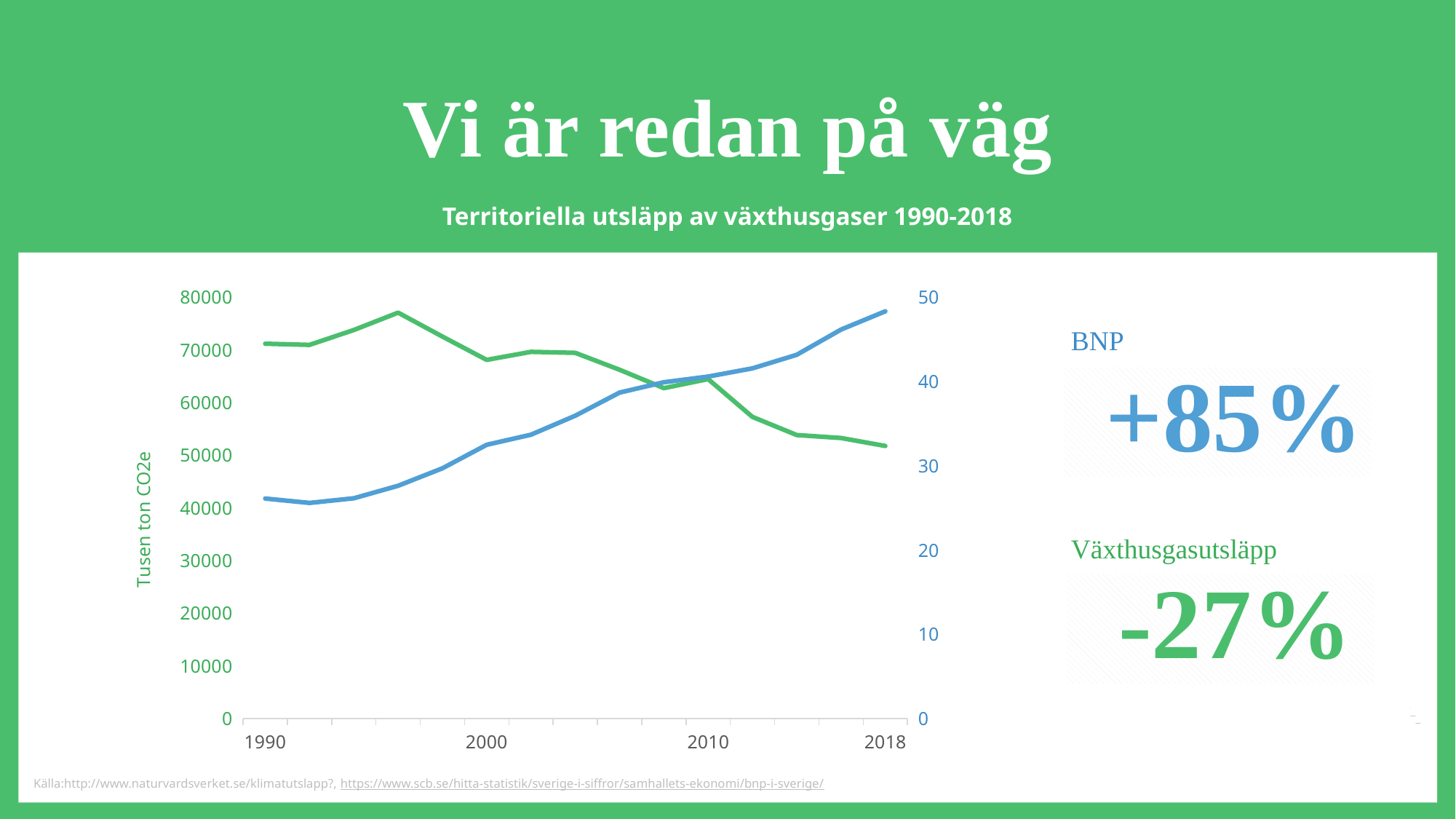
Which year has the higher value on the green line, 1990 or 2018? 1990 Does the blue line (BNP) rise or fall overall from 1990 to 2018? rise Is the value of the blue line (BNP) in 2018 greater or less than 40 on the right axis? greater Is the value of the green line in 2018 greater or less than 60000? less Does the green line (Växthusgasutsläpp) rise or fall overall from 1990 to 2018? fall How many lines (series) are plotted on the chart? 2 What is the label of the left vertical axis? Tusen ton CO2e What kind of chart is shown on the slide? line chart Is the value of the green line in 1990 greater or less than 60000? greater According to the slide, by what percentage did BNP change over the period? +85% What is the title of the chart on the slide? Territoriella utsläpp av växthusgaser 1990-2018